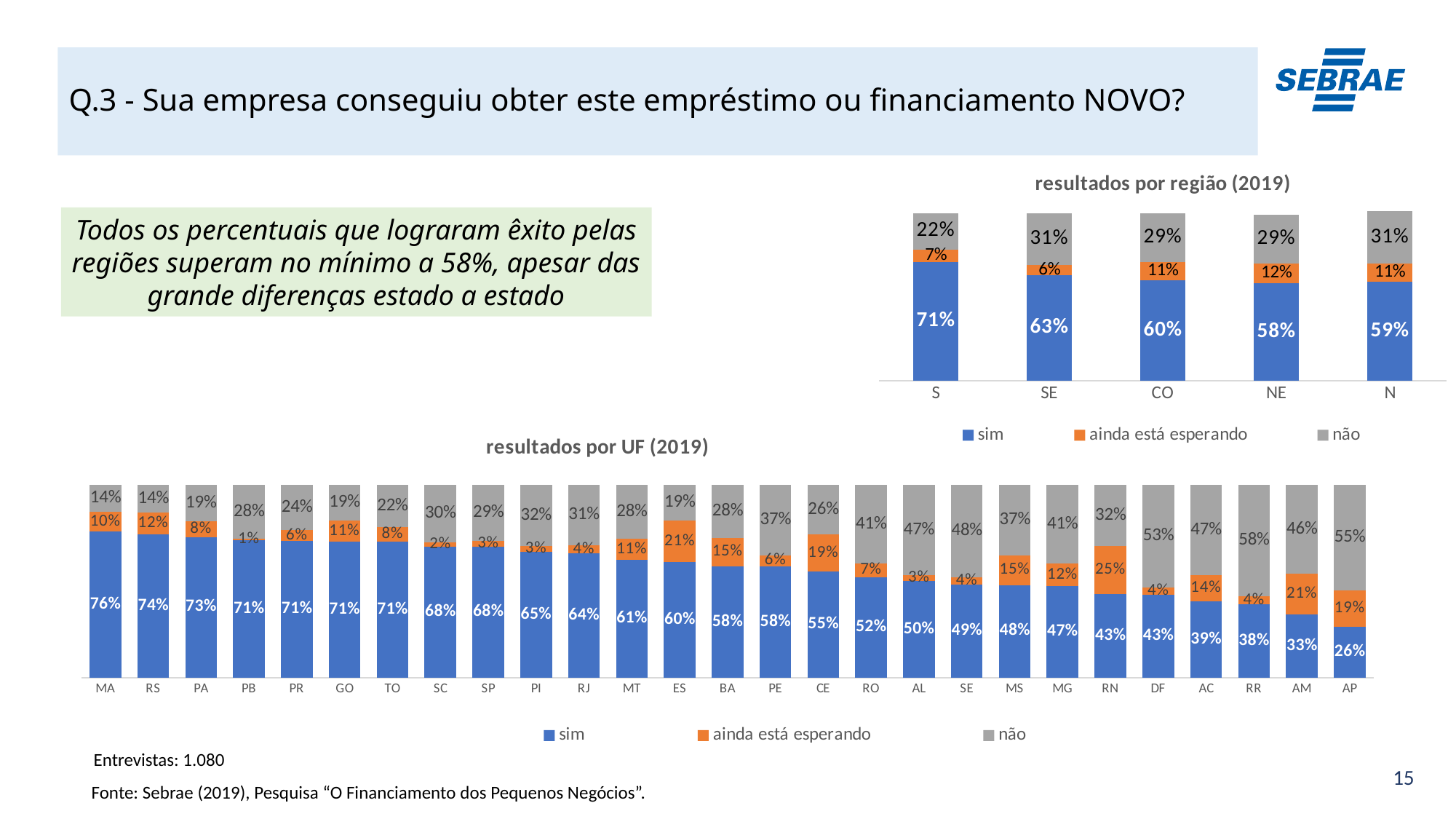
In the 'resultados por UF (2019)' chart, which UF has the lowest 'sim' value? AP In the 'resultados por região (2019)' chart, which region has the lowest 'sim' value? NE In the 'resultados por região (2019)' chart, how many series does the legend list? 3 In the 'resultados por região (2019)' chart, what is the difference between the 'sim' values for S and CO? 11% In the 'resultados por região (2019)' chart, what is the 'não' value for SE? 31% What kind of chart is 'resultados por UF (2019)'? Stacked bar chart In the 'resultados por UF (2019)' chart, how many UFs are shown on the x axis? 27 In the 'resultados por UF (2019)' chart, what is the 'não' value for RR? 58% In the 'resultados por região (2019)' chart, what is the 'sim' value for S? 71% In the 'resultados por UF (2019)' chart, what is the 'ainda está esperando' value for RN? 25% In the 'resultados por UF (2019)' chart, which UF has the highest 'sim' value? MA In the 'resultados por UF (2019)' chart, which is larger, the 'sim' value for ES or for CE? ES